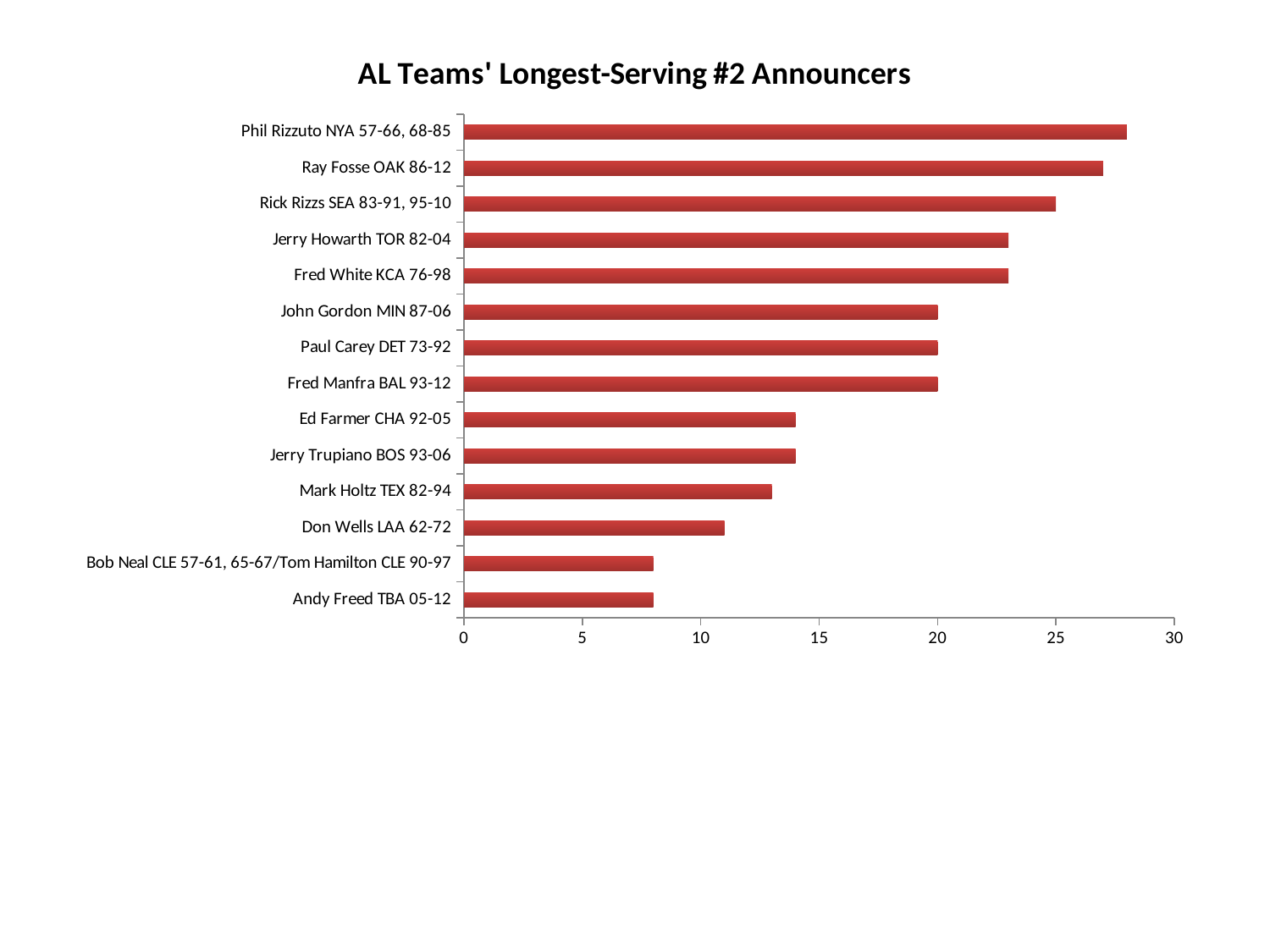
How many announcers (categories) are shown in the chart? 14 Is the value for Don Wells LAA 62-72 greater or less than 10? greater What is the title of the chart? AL Teams' Longest-Serving #2 Announcers What is the value for John Gordon MIN 87-06? 20 Which is larger, the value for Fred White KCA 76-98 or the value for Mark Holtz TEX 82-94? Fred White KCA 76-98 Which announcer has the longest bar in the chart? Phil Rizzuto NYA 57-66, 68-85 What is the value for Rick Rizzs SEA 83-91, 95-10? 25 Is the value for Phil Rizzuto NYA 57-66, 68-85 greater or less than 25? greater Which is larger, the value for Ray Fosse OAK 86-12 or the value for Jerry Howarth TOR 82-04? Ray Fosse OAK 86-12 What kind of chart is shown on the slide? bar chart Is the value for Ed Farmer CHA 92-05 greater or less than 15? less